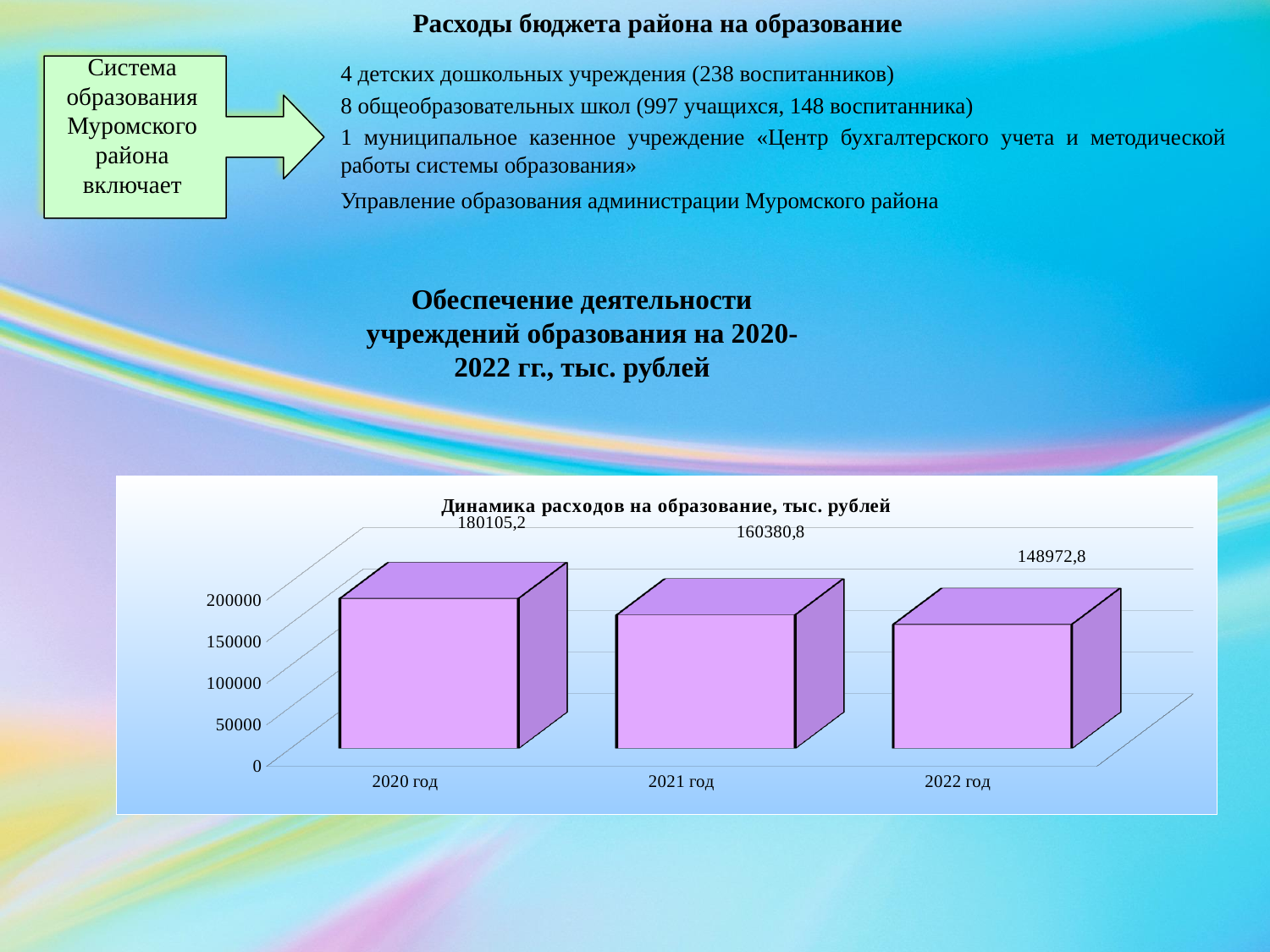
How many years (categories) are shown in the chart 'Динамика расходов на образование, тыс. рублей'? 3 Which year has the highest value in the chart 'Динамика расходов на образование, тыс. рублей'? 2020 год In the chart 'Динамика расходов на образование, тыс. рублей', which is larger: the value for 2021 год or 2022 год? 2021 год Do the values in the chart 'Динамика расходов на образование, тыс. рублей' rise or fall from 2020 год to 2022 год? fall Which year has the lowest value in the chart 'Динамика расходов на образование, тыс. рублей'? 2022 год In the chart 'Динамика расходов на образование, тыс. рублей', what is the difference between the values for 2020 год and 2021 год? 19724,4 In the chart 'Динамика расходов на образование, тыс. рублей', what is the difference between the values for 2021 год and 2022 год? 11408 What is the value for 2021 год in the chart 'Динамика расходов на образование, тыс. рублей'? 160380,8 What is the value for 2020 год in the chart 'Динамика расходов на образование, тыс. рублей'? 180105,2 What kind of chart is 'Динамика расходов на образование, тыс. рублей'? bar chart What is the value for 2022 год in the chart 'Динамика расходов на образование, тыс. рублей'? 148972,8 In the chart 'Динамика расходов на образование, тыс. рублей', is the value for 2022 год greater or less than 150000? less